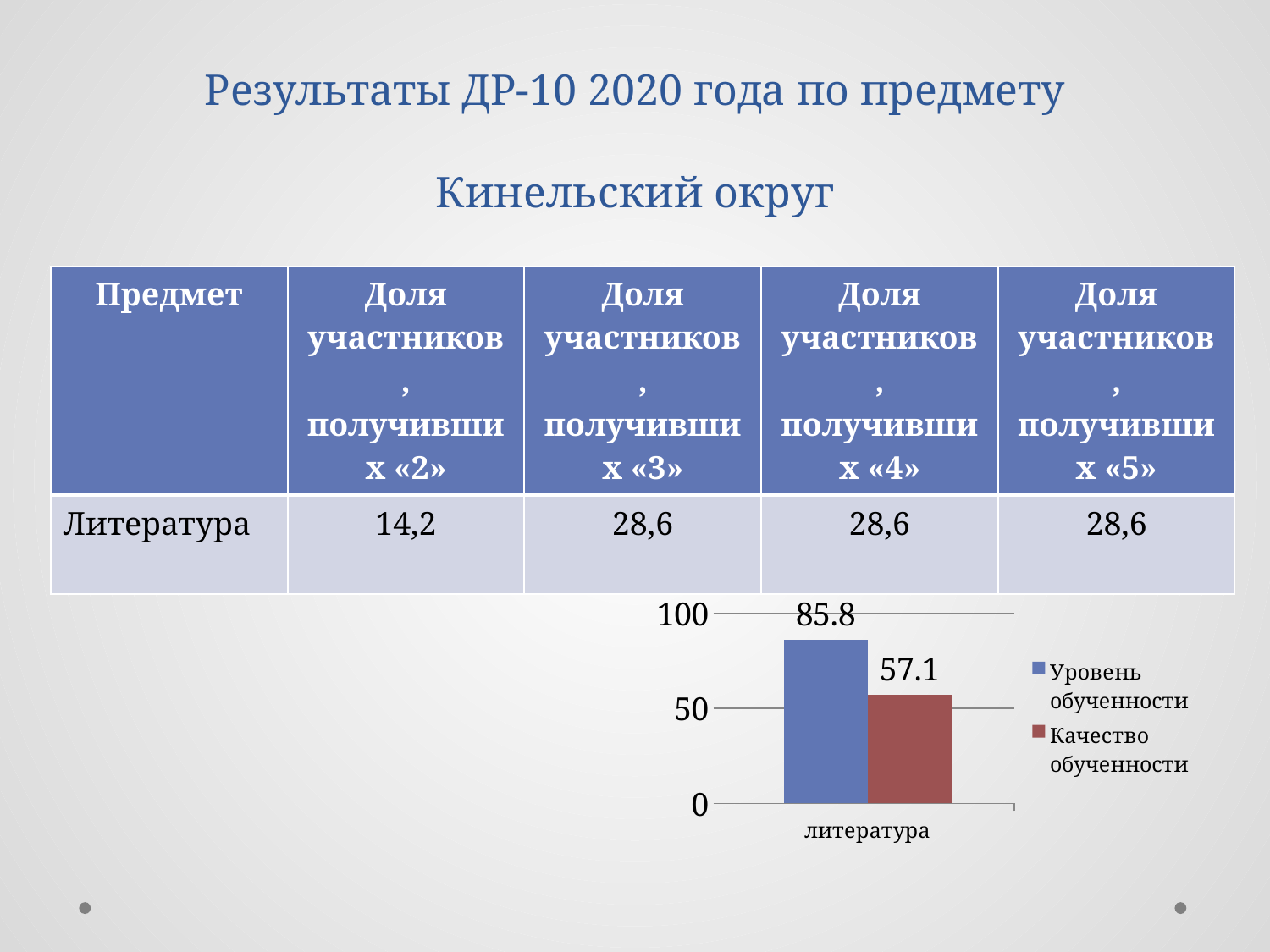
How many categories are shown on the x axis of the chart? 1 What is the difference between Уровень обученности and Качество обученности for литература? 28.7 Is the value of Уровень обученности for литература greater or less than 100? less What is the category label on the x axis of the chart? литература How many series does the chart legend list? 2 What is the value of Качество обученности for литература? 57.1 What colour is the bar for Качество обученности? red Which series has the lowest value in the chart? Качество обученности Is the value of Качество обученности for литература greater or less than 50? greater What is the value of Уровень обученности for литература? 85.8 Which series has the higher value for литература, Уровень обученности or Качество обученности? Уровень обученности What kind of chart is shown on the slide? bar chart